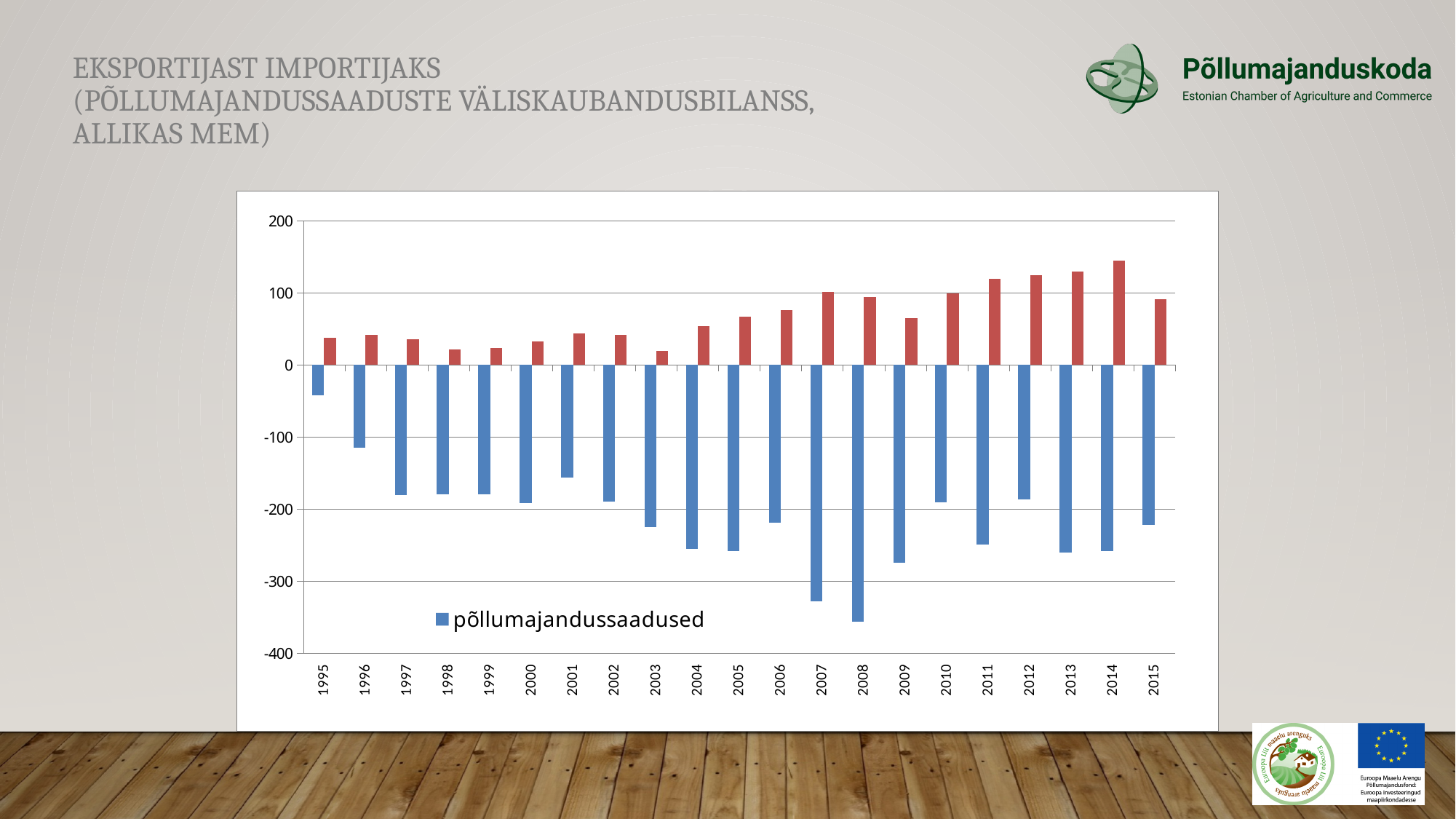
Which year has the larger value in the red series, 2014 or 2015? 2014 How many years are shown on the x axis of the chart? 21 In which year does the blue series põllumajandussaadused reach its lowest (most negative) value? 2008 In which year is the blue series põllumajandussaadused closest to zero (its highest value)? 1995 What kind of chart is shown on the slide? bar chart How many series does the chart's legend list? 1 What is the name of the series listed in the chart's legend? põllumajandussaadused In which year does the red series reach its highest value? 2014 Is the value of the blue series põllumajandussaadused for 2003 greater or less than -200? less Is the value of the red series for 2011 greater or less than 100? greater What colour are the bars for the series põllumajandussaadused? blue Is the value of the blue series põllumajandussaadused for 2008 greater or less than -300? less